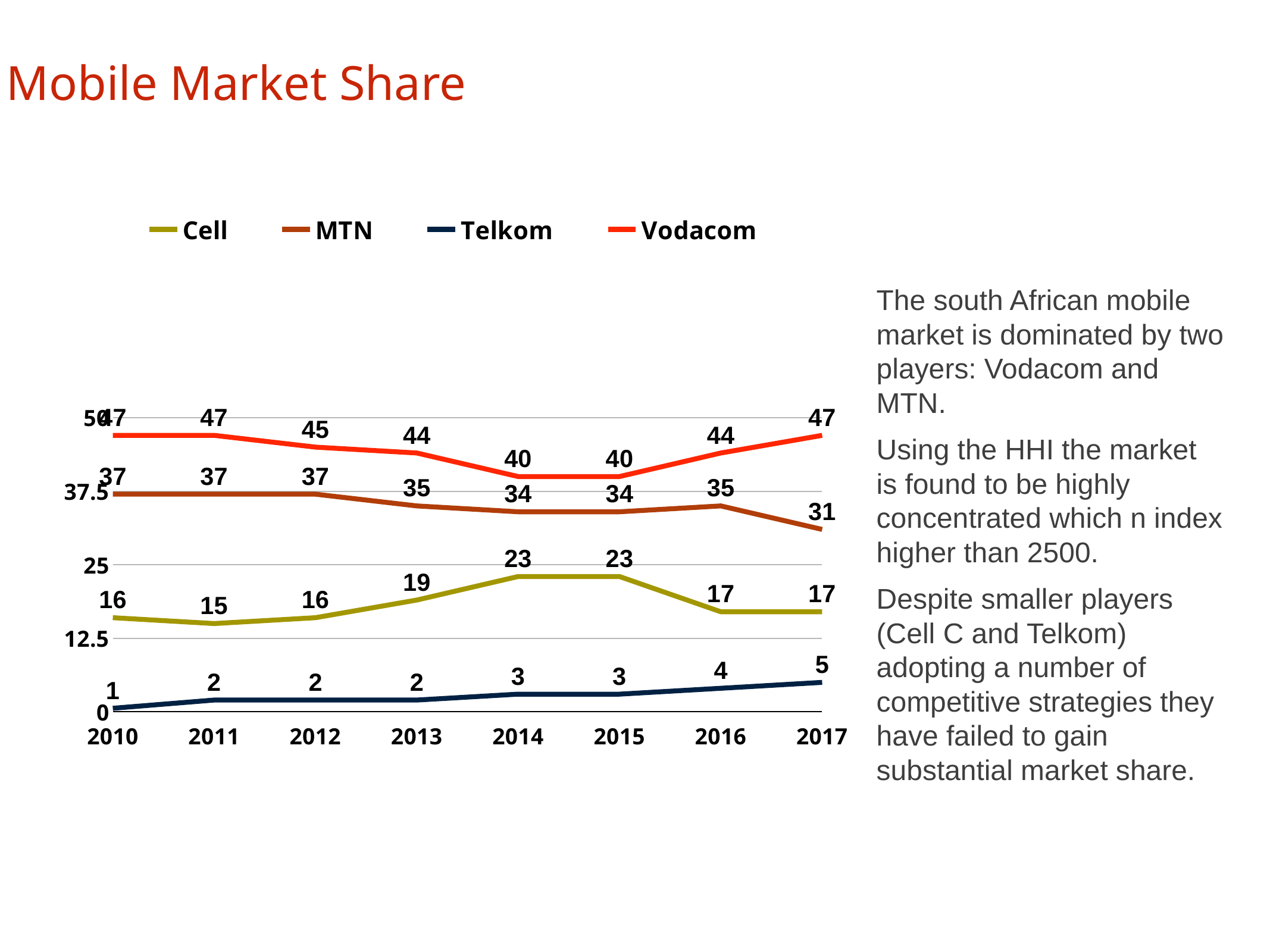
How many years are shown on the x axis? 8 Which is larger in 2012, Cell or MTN? MTN What is the value for Vodacom in 2014? 40 What is the value for Cell in 2013? 19 How many series does the legend list? 4 What kind of chart is shown on the slide? line chart In which year is the MTN series at its lowest value? 2017 Does the Telkom series rise or fall from 2010 to 2017? rise What is the difference between Vodacom and MTN in 2017? 16 In which year is the Cell series at its highest value? 2014 and 2015 What is the value for MTN in 2017? 31 What is the value for Telkom in 2016? 4